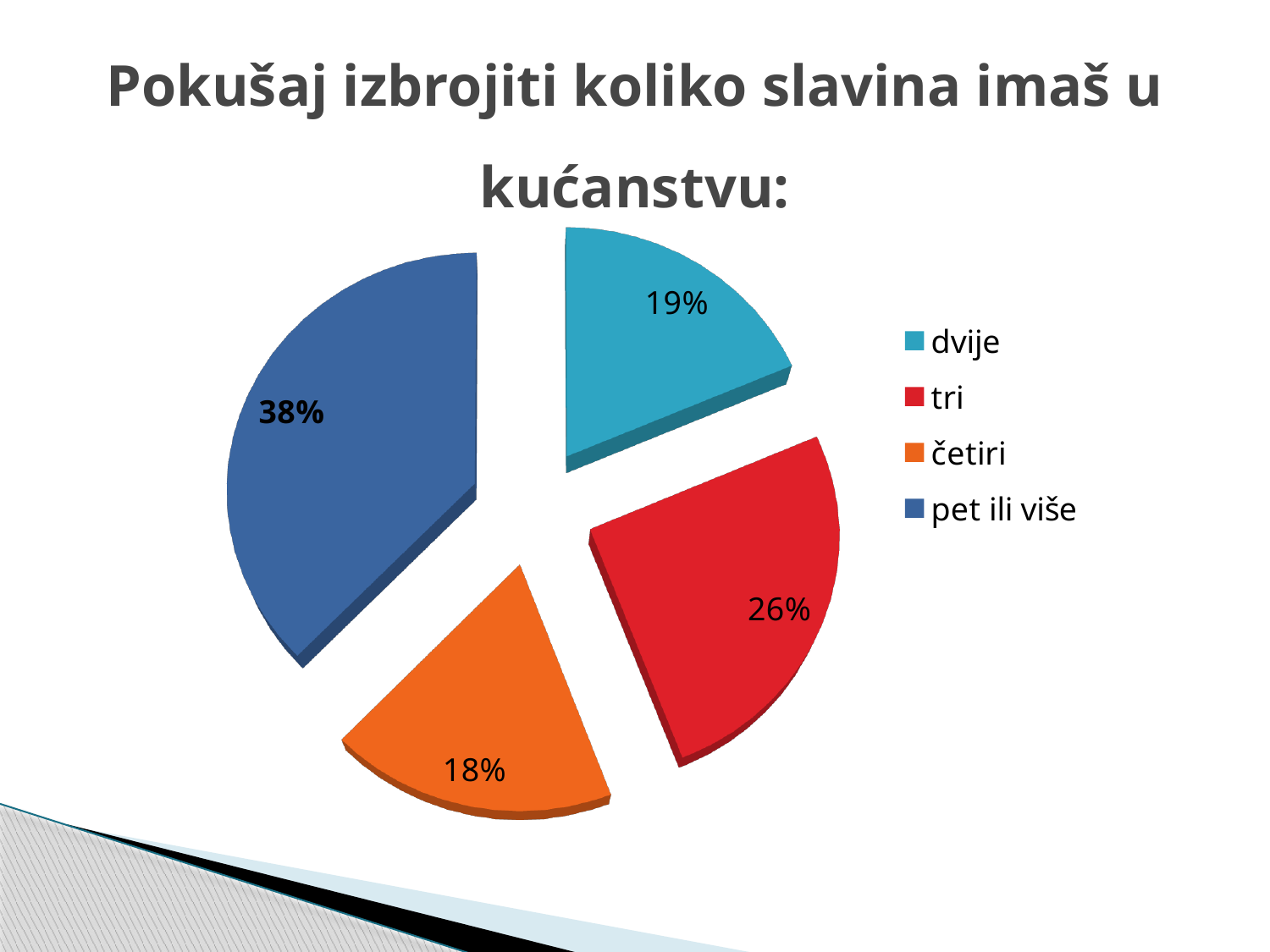
What kind of chart is shown on the slide? pie chart What share of the pie does the "tri" slice represent? 26% Which slice is larger, "tri" or "dvije"? tri What is the difference in percentage points between the "pet ili više" slice and the "tri" slice? 12 How many categories are shown in the pie chart? 4 What is the title of the chart on the slide? Pokušaj izbrojiti koliko slavina imaš u kućanstvu: What share of the pie does the "pet ili više" slice represent? 38% What share of the pie does the "četiri" slice represent? 18% Which category has the smallest slice of the pie? četiri Which category has the largest slice of the pie? pet ili više What colour is the "četiri" slice in the pie chart? orange